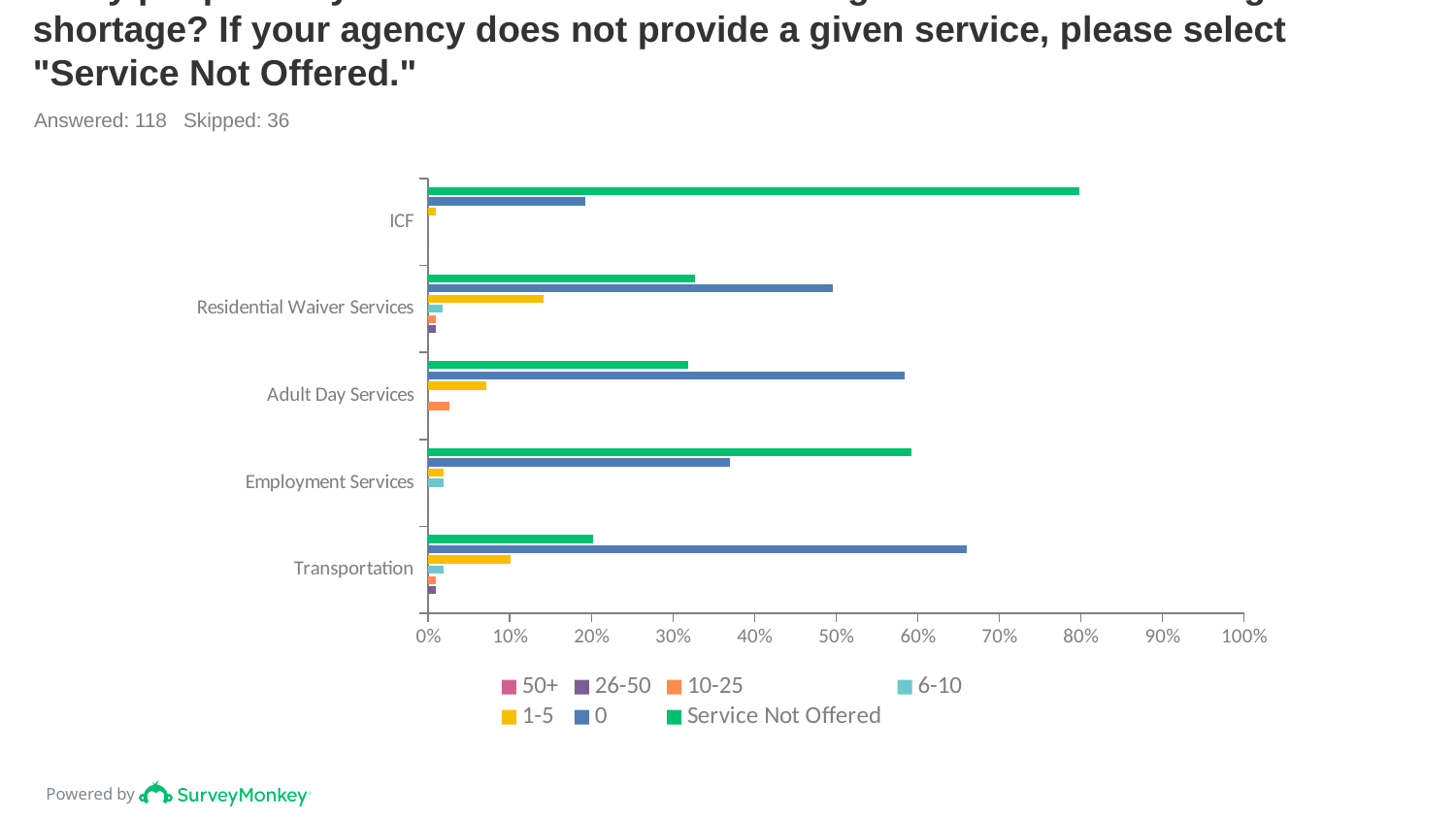
Is the value for "Service Not Offered" in Employment Services greater or less than 50%? greater For Employment Services, which is larger: the "0" bar or the "Service Not Offered" bar? Service Not Offered What kind of chart is shown on the slide? bar chart Is the value for "0" in Adult Day Services greater or less than 50%? greater Which service category has the highest value for "Service Not Offered"? ICF How many service categories are shown on the y axis of the chart? 5 Which service category has the highest value for the "0" series? Transportation How many series does the chart's legend list? 7 Is the value for "0" in Transportation greater or less than 60%? greater How many respondents answered this question according to the slide? 118 Which service category has the lowest value for "Service Not Offered"? Transportation